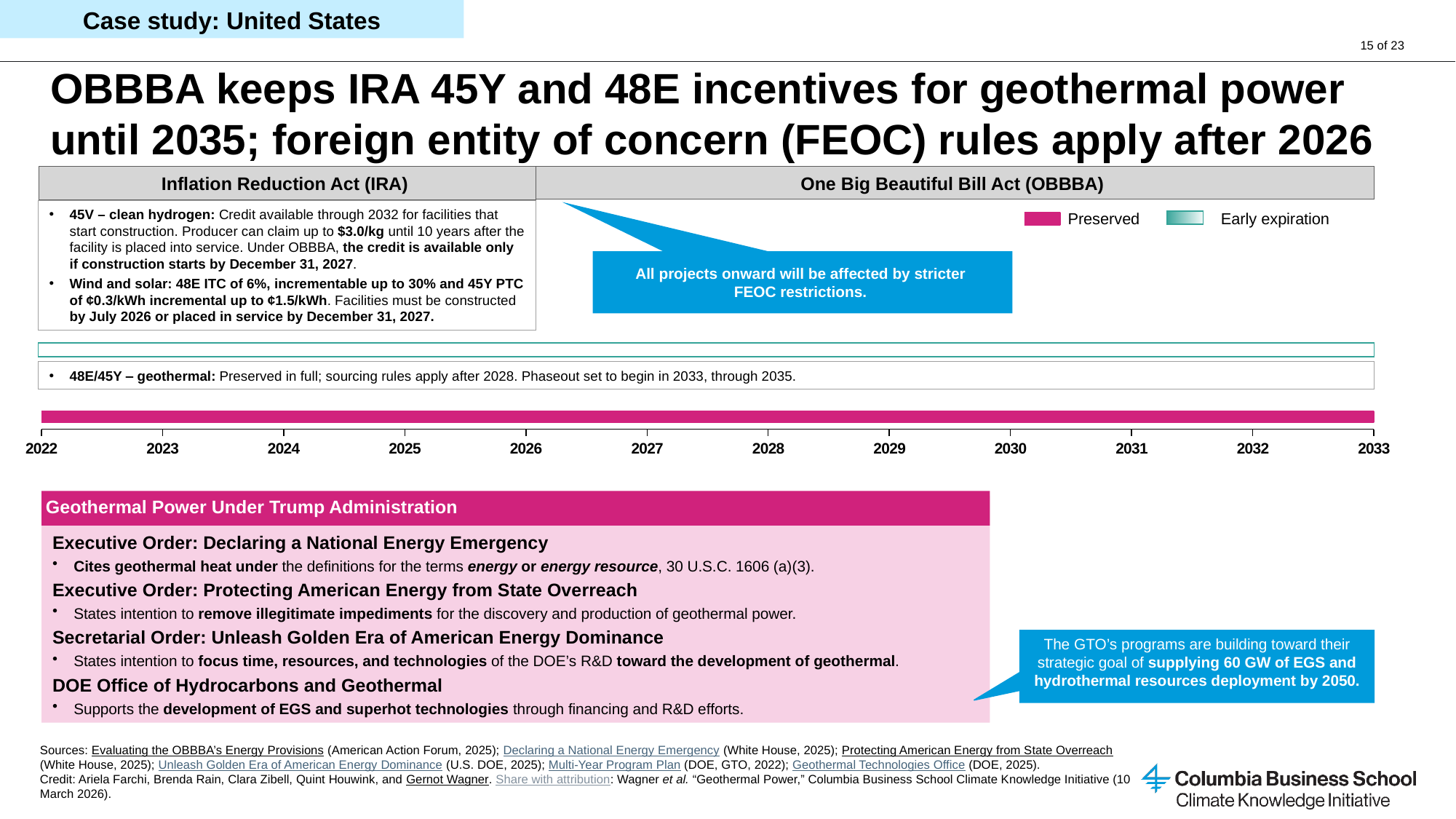
What is the last year shown on the x axis of the timeline chart? 2033 Which legend category does the solid pink bar spanning 2022 to 2033 belong to? Preserved What is the first year shown on the x axis of the timeline chart? 2022 What colour is used for the 'Preserved' legend entry on the timeline chart? Pink What are the two legend entries on the timeline chart? Preserved and Early expiration How many entries does the legend of the timeline chart list? 2 In which year does the pink 'Preserved' bar on the timeline chart begin? 2022 How many year labels are shown along the x axis of the timeline chart? 12 What kind of chart is shown beneath the IRA/OBBBA table? A timeline bar chart Does the pink 'Preserved' bar on the timeline chart extend past 2030? Yes In which year does the pink 'Preserved' bar on the timeline chart end? 2033